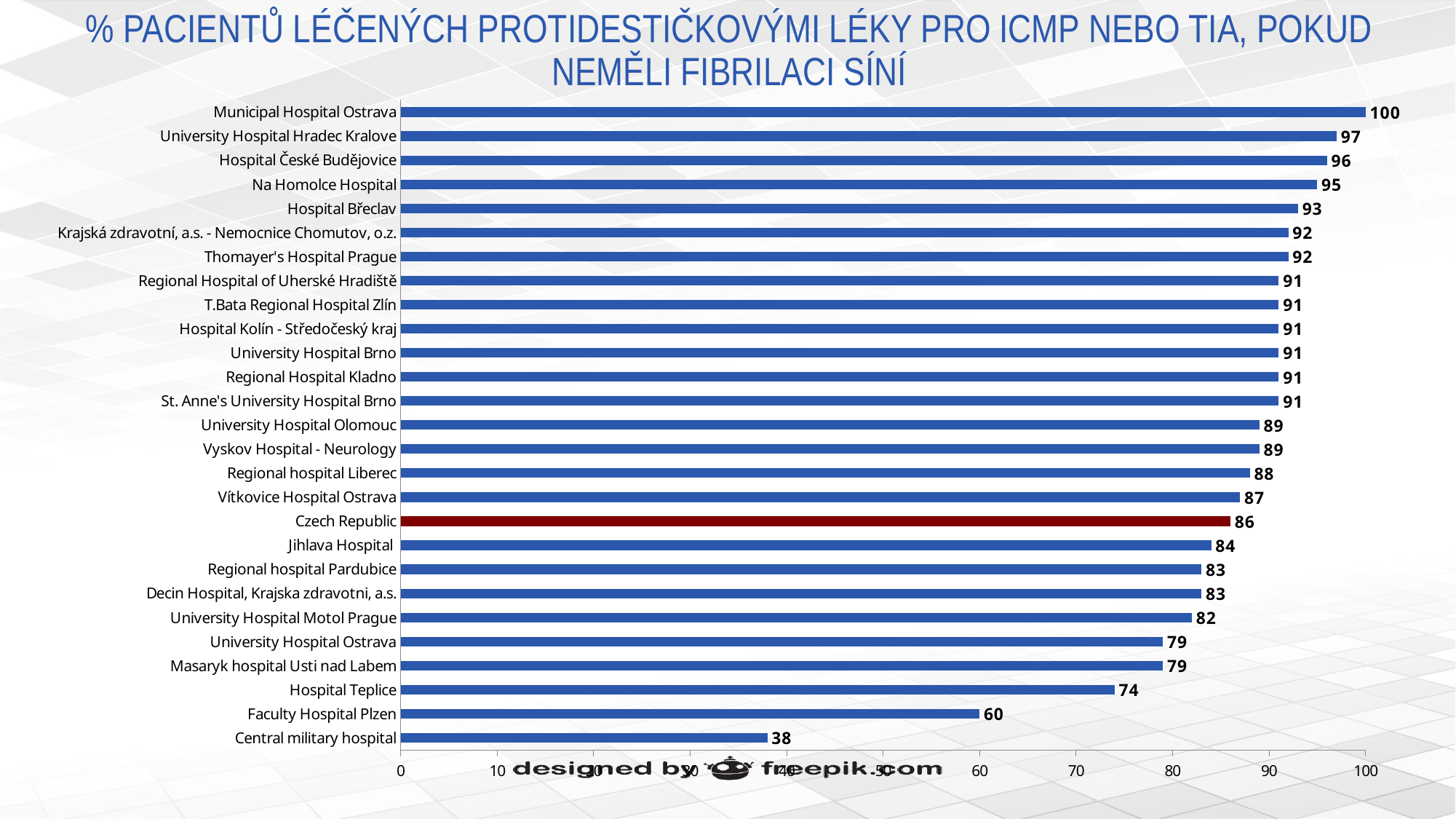
Which category has the highest value? Municipal Hospital Ostrava Which is larger, the value for University Hospital Motol Prague or the value for Hospital Teplice? University Hospital Motol Prague What is the difference between the values for Municipal Hospital Ostrava and Central military hospital? 62 What is the difference between the values for Czech Republic and Faculty Hospital Plzen? 26 What is the value for Hospital Teplice? 74 What is the value for Municipal Hospital Ostrava? 100 What is the value for Czech Republic? 86 Which category's bar is drawn in a different colour (dark red) from the others? Czech Republic What is the value for Faculty Hospital Plzen? 60 How many categories are shown on the chart? 27 Which category has the lowest value? Central military hospital What kind of chart is shown on the slide? bar chart